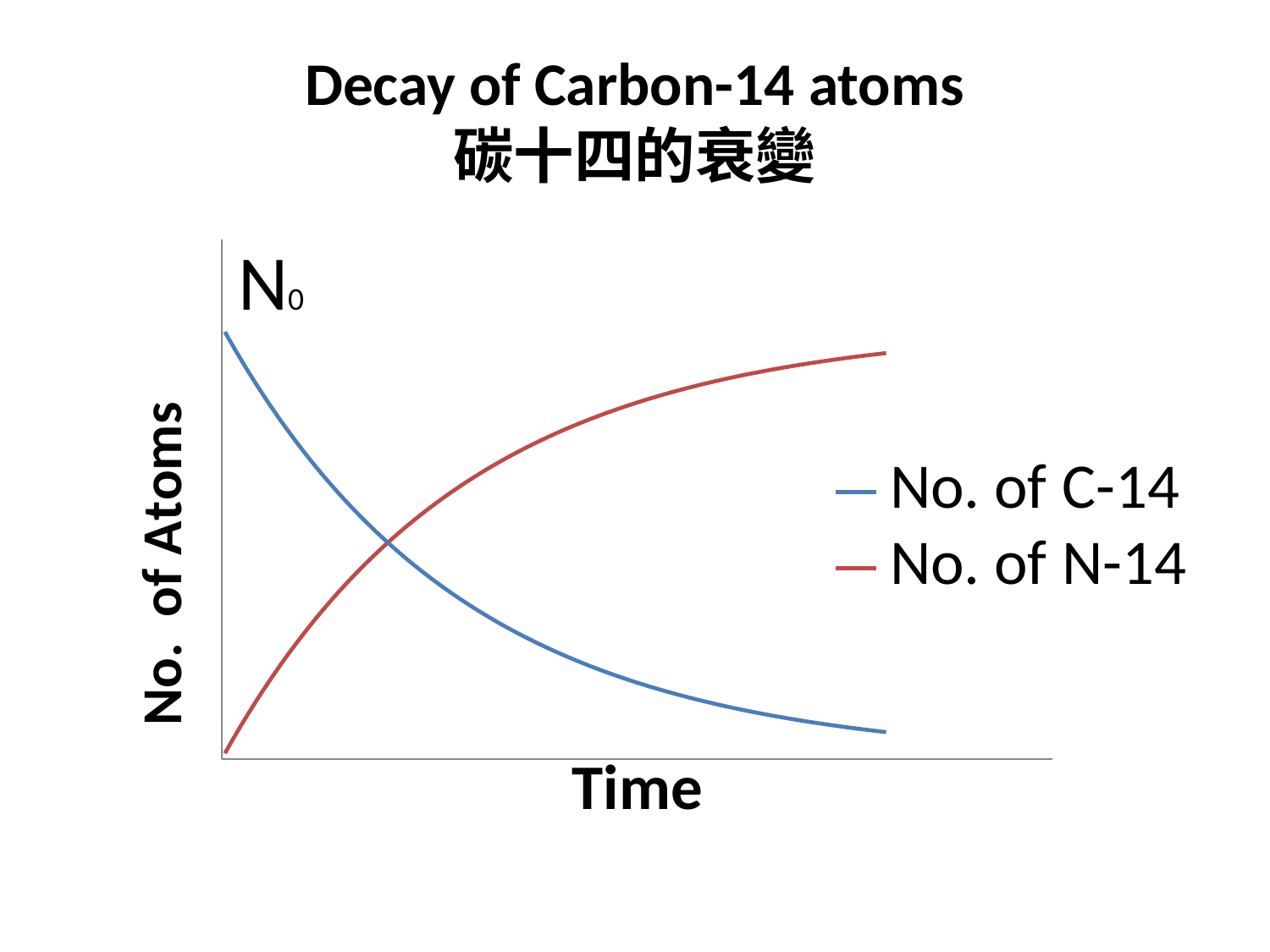
What is the label of the horizontal axis? Time Which series starts at the value labelled N0 on the vertical axis? No. of C-14 Does the number of N-14 atoms rise or fall as time increases? Rise At the start of the time axis, which series has the higher value, No. of C-14 or No. of N-14? No. of C-14 Does the number of C-14 atoms rise or fall as time increases? Fall What kind of chart is shown on the slide? Line chart How many series does the legend list? 2 At the end of the time axis, which series has the higher value, No. of C-14 or No. of N-14? No. of N-14 What colour is the line for No. of N-14? Red